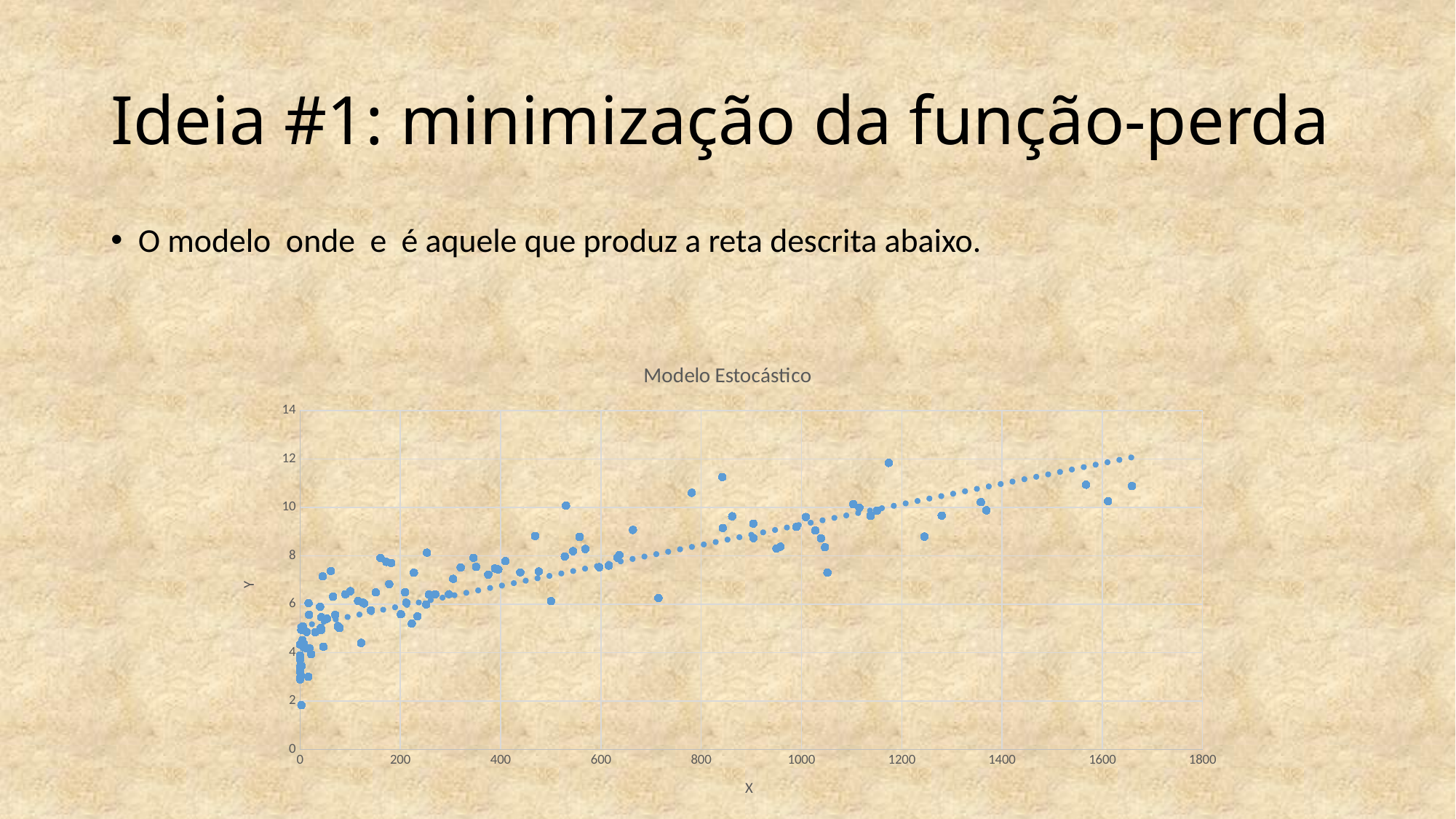
Are the points plotted near X = 1600 greater or less than 8 on the Y axis? greater What is the highest tick value shown on the X axis? 1800 Do the plotted Y values generally rise or fall as X increases? rise Which has the larger Y value: the point near X = 1170 or the point near X = 700? the point near X = 1170 Is the isolated point plotted near X = 700 greater or less than 8 on the Y axis? less What is the title of the chart? Modelo Estocástico Is the lowest plotted point on the chart greater or less than 4? less What kind of chart is shown on the slide? scatter chart